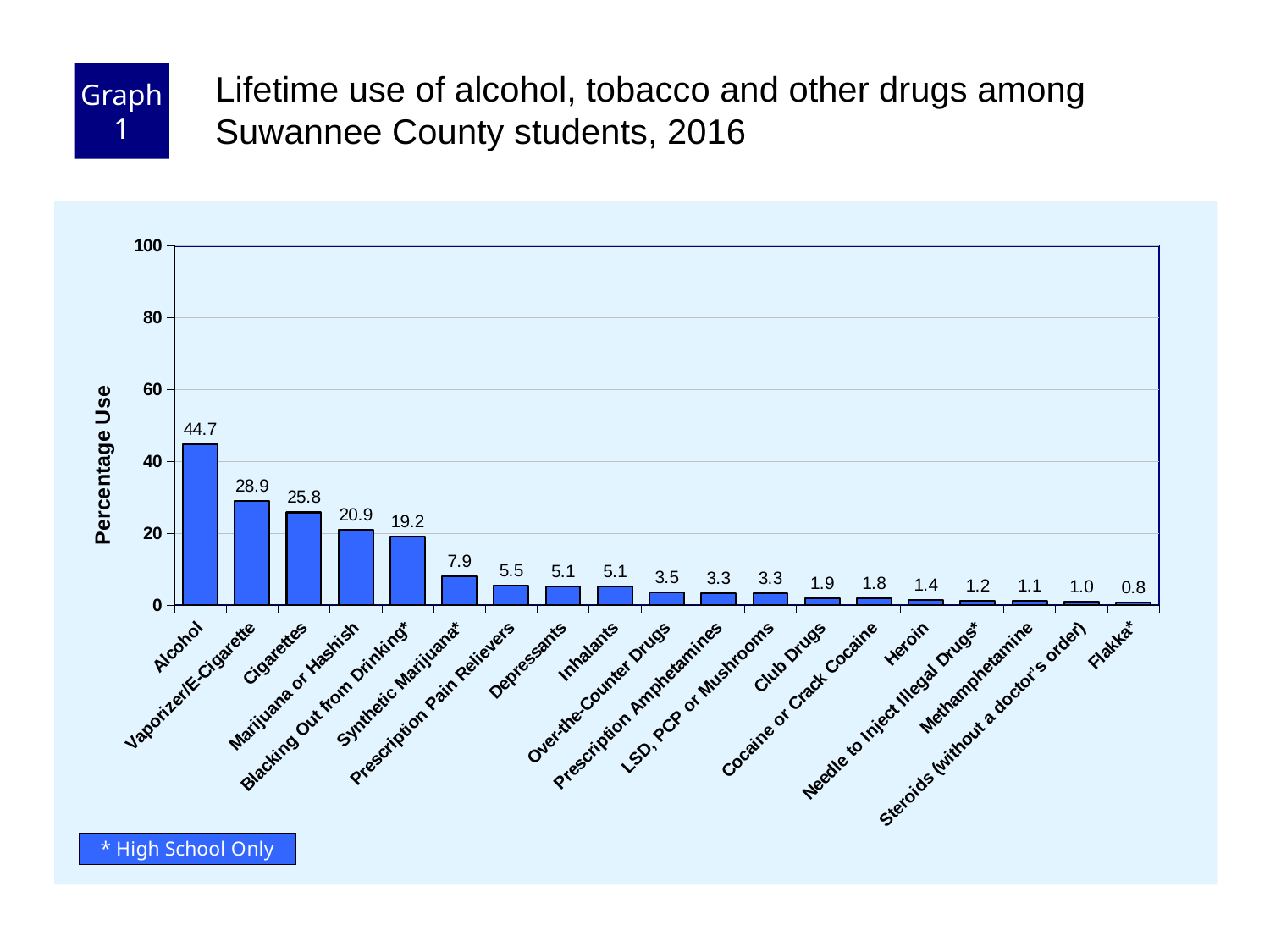
What is the percentage of lifetime use for Heroin? 1.4 What is the percentage of lifetime use for Vaporizer/E-Cigarette? 28.9 Is the value for Alcohol greater or less than 40? greater How many categories are shown on the x axis? 19 What is the percentage of lifetime use for Synthetic Marijuana? 7.9 Which category has the lowest percentage of lifetime use? Flakka* What kind of chart is shown on the slide? Bar chart Which has a higher percentage of lifetime use, Blacking Out from Drinking or Synthetic Marijuana? Blacking Out from Drinking* What is the difference in percentage use between Cigarettes and Marijuana or Hashish? 4.9 What is the percentage of lifetime use for Alcohol? 44.7 Which category has the highest percentage of lifetime use? Alcohol What is the label of the y axis? Percentage Use